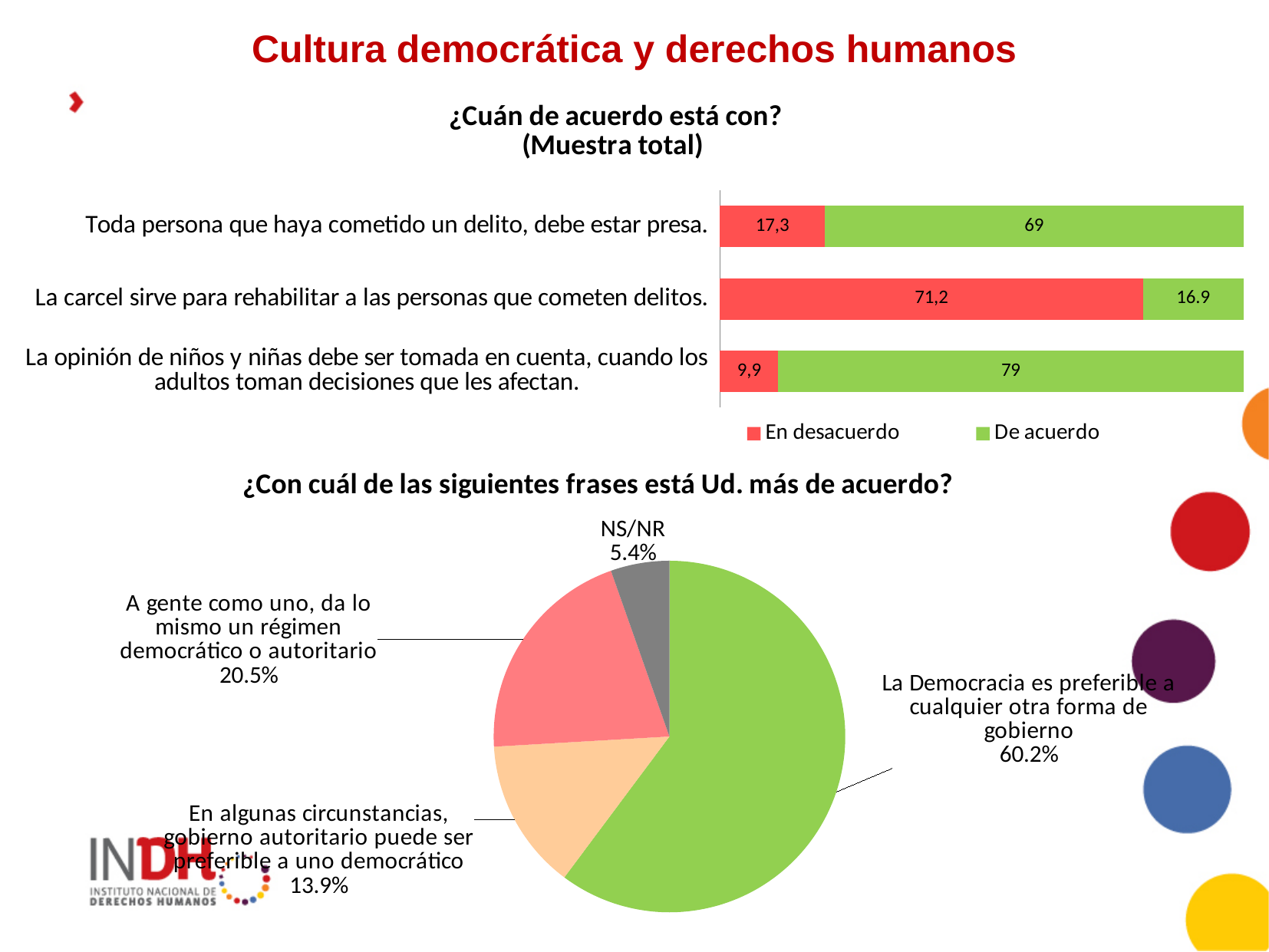
In the bar chart '¿Cuán de acuerdo está con?', how many series does the legend list? 2 In the pie chart '¿Con cuál de las siguientes frases está Ud. más de acuerdo?', which is larger: 'A gente como uno, da lo mismo un régimen democrático o autoritario' or 'En algunas circunstancias, gobierno autoritario puede ser preferible a uno democrático'? A gente como uno, da lo mismo un régimen democrático o autoritario In the bar chart '¿Cuán de acuerdo está con?', what is the 'En desacuerdo' value for 'La carcel sirve para rehabilitar a las personas que cometen delitos.'? 71,2 In the pie chart '¿Con cuál de las siguientes frases está Ud. más de acuerdo?', what share does 'La Democracia es preferible a cualquier otra forma de gobierno' have? 60.2% In the pie chart '¿Con cuál de las siguientes frases está Ud. más de acuerdo?', what is the value for 'NS/NR'? 5.4% What kind of chart is the lower chart on the slide? Pie chart In the bar chart '¿Cuán de acuerdo está con?', what is the 'En desacuerdo' value for 'La opinión de niños y niñas debe ser tomada en cuenta, cuando los adultos toman decisiones que les afectan.'? 9,9 In the bar chart '¿Cuán de acuerdo está con?', which statement has the lowest 'De acuerdo' value? La carcel sirve para rehabilitar a las personas que cometen delitos. In the bar chart '¿Cuán de acuerdo está con?', which colour represents 'En desacuerdo'? Red In the bar chart '¿Cuán de acuerdo está con?', how many statements are shown? 3 In the bar chart '¿Cuán de acuerdo está con?', which statement has the highest 'De acuerdo' value? La opinión de niños y niñas debe ser tomada en cuenta, cuando los adultos toman decisiones que les afectan. In the bar chart '¿Cuán de acuerdo está con?', what is the 'De acuerdo' value for 'Toda persona que haya cometido un delito, debe estar presa.'? 69